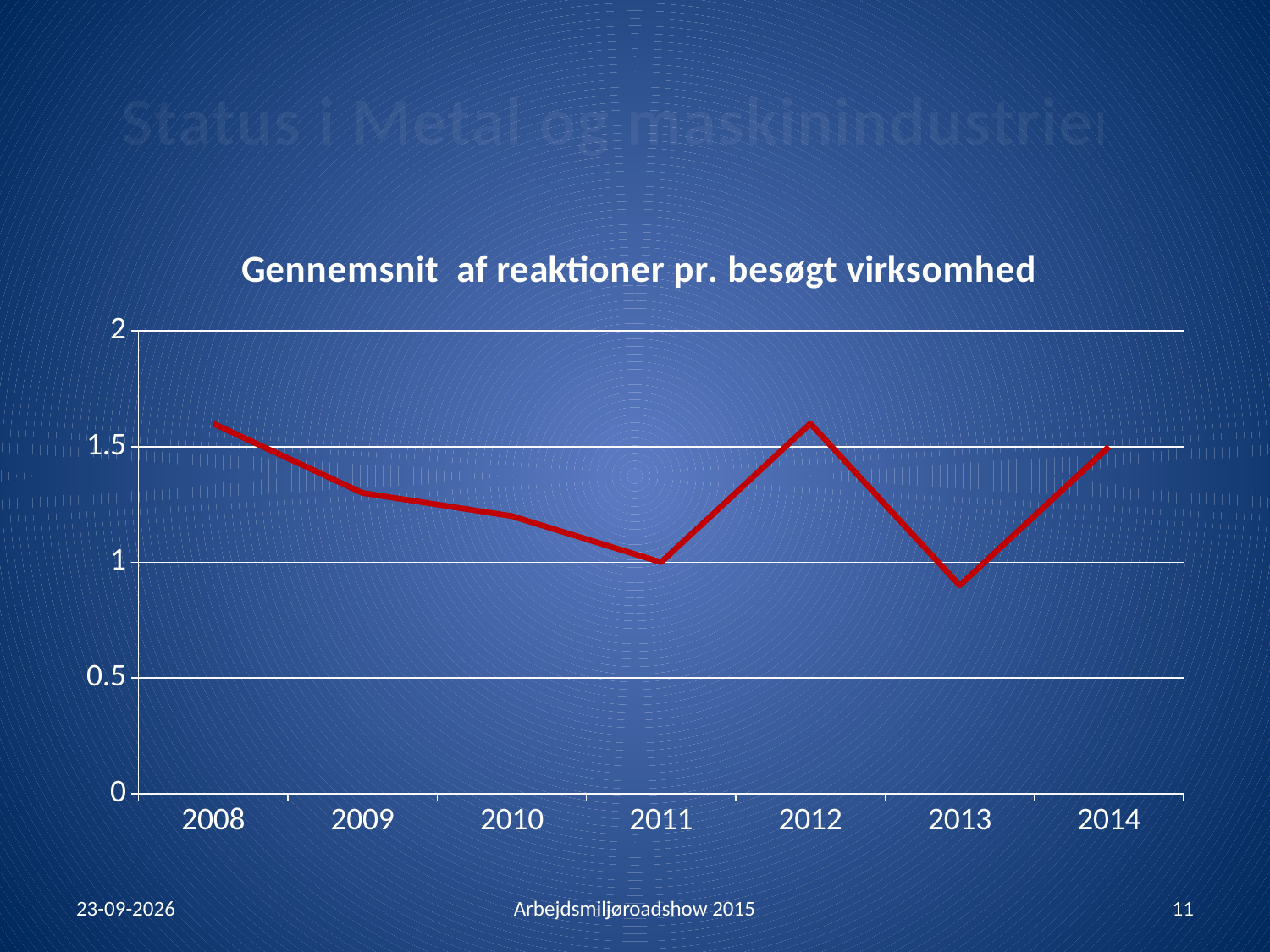
Is the value for 2009 greater or less than 1.5? less Do the values rise or fall from 2008 to 2011? fall What is the value for 2014? 1.5 Is the value for 2013 greater or less than 1? less How many years are plotted on the x axis? 7 What kind of chart is shown on the slide? line chart Is the value for 2008 greater or less than 1.5? greater Which year has the lowest value? 2013 Which is larger, the value for 2012 or the value for 2013? 2012 What is the value for 2011? 1 What is the title of the chart? Gennemsnit af reaktioner pr. besøgt virksomhed